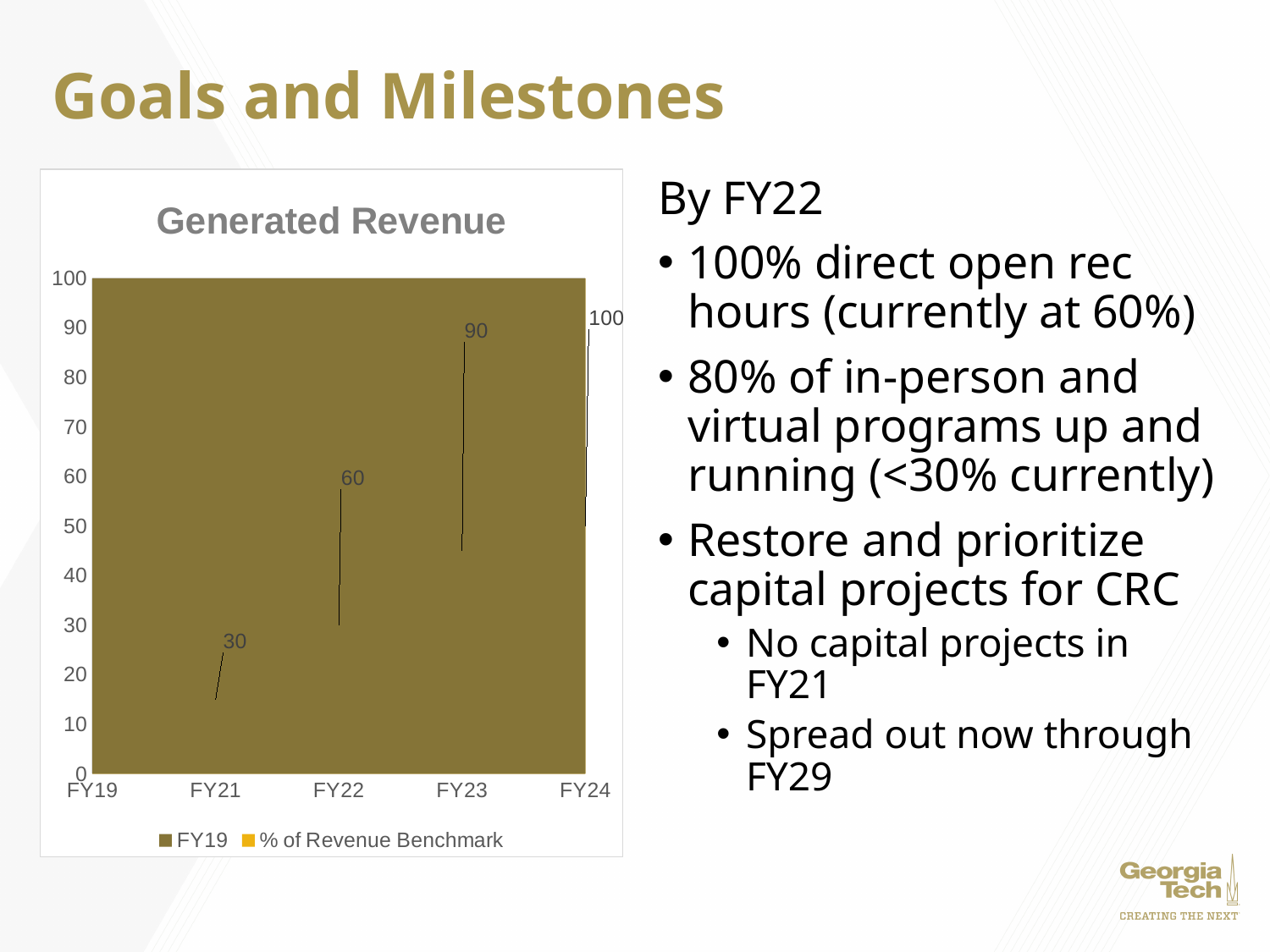
What is the % of Revenue Benchmark value for FY24? 100 How many fiscal years are shown on the x axis of the chart? 5 What is the % of Revenue Benchmark value for FY22? 60 Do the % of Revenue Benchmark values rise or fall from FY21 to FY24? rise Which has a higher % of Revenue Benchmark value, FY22 or FY23? FY23 What is the difference between the % of Revenue Benchmark values for FY23 and FY21? 60 How many series does the chart legend list? 2 Among the labeled % of Revenue Benchmark values, which fiscal year has the highest? FY24 Among the labeled % of Revenue Benchmark values, which fiscal year has the lowest? FY21 What is the % of Revenue Benchmark value for FY21? 30 What is the % of Revenue Benchmark value for FY23? 90 What is the difference between the % of Revenue Benchmark values for FY24 and FY22? 40